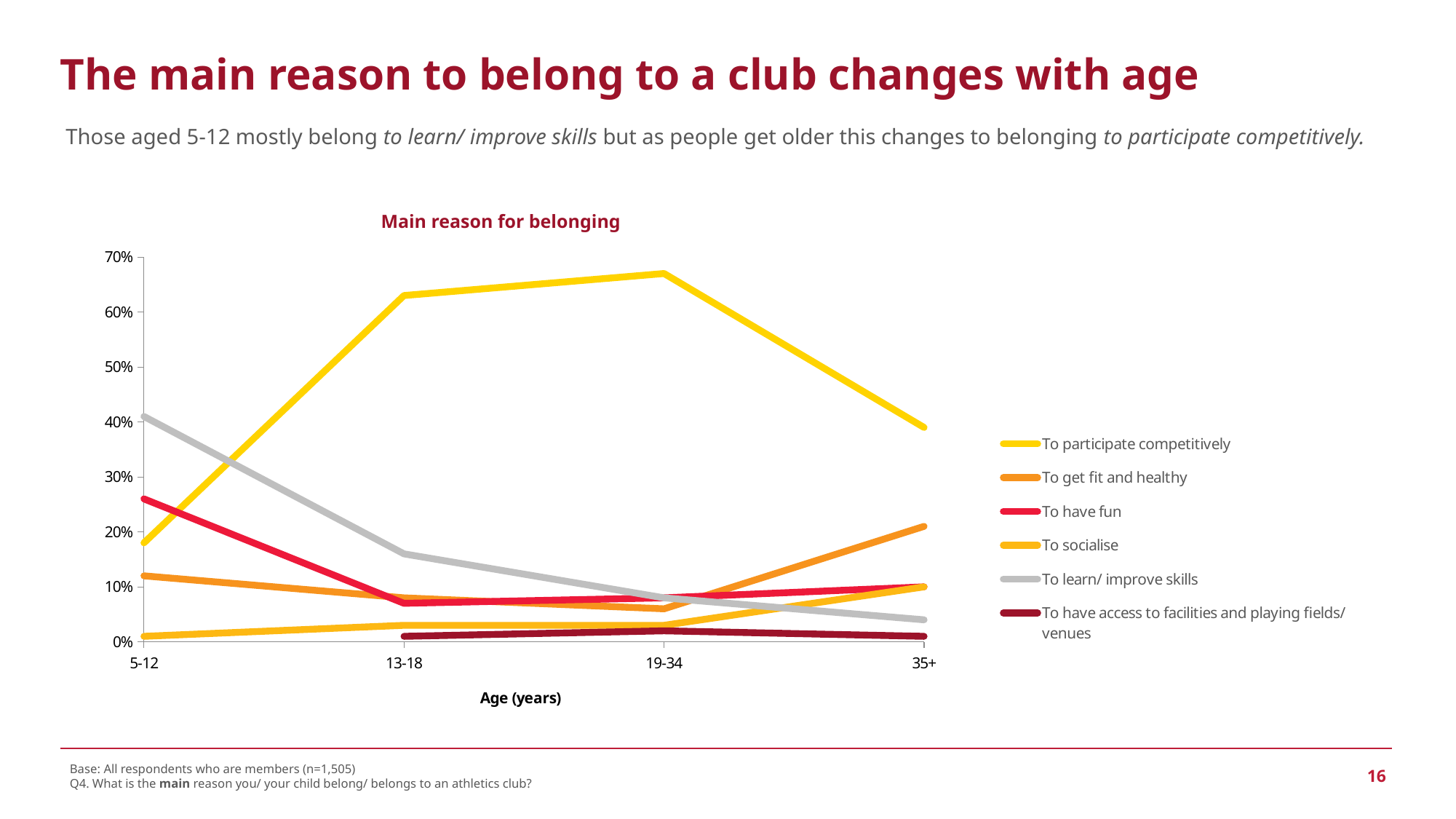
How does the value for 'To learn/ improve skills' change as age increases from 5-12 to 35+? It falls Is the value for 'To learn/ improve skills' at 35+ greater or less than 10%? less Which reason has the highest value for the 5-12 age group? To learn/ improve skills What kind of chart is shown on the slide? Line chart Is the value for 'To have fun' at 5-12 greater or less than 20%? greater Which reason has the highest value for the 19-34 age group? To participate competitively How many series does the legend list? 6 Which reason has the lowest value for the 35+ age group? To have access to facilities and playing fields/ venues Is the value for 'To participate competitively' at 19-34 greater or less than 60%? greater For the 35+ age group, which is larger: 'To get fit and healthy' or 'To have fun'? To get fit and healthy How many age groups are shown on the x axis? 4 What is the label on the x axis of the chart? Age (years)